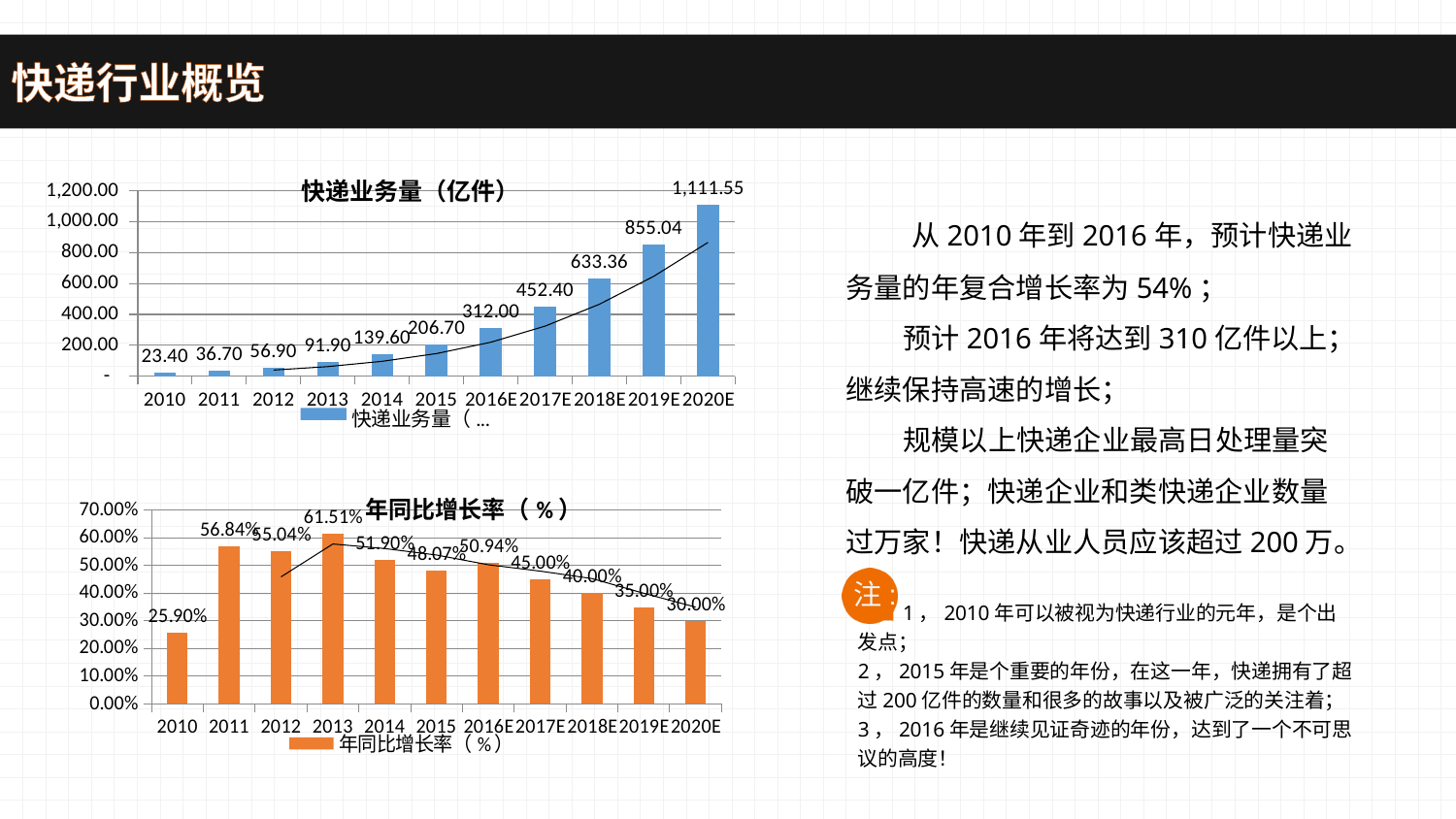
In the 快递业务量（亿件） chart, what is the value for 2015? 206.70 In the 年同比增长率（%） chart, what is the difference between the values for 2018E and 2019E? 5.00% In the 年同比增长率（%） chart, which year has the lowest value? 2010 In the 年同比增长率（%） chart, which is larger, the value for 2011 or the value for 2012? 2011 What kind of chart is the 年同比增长率（%） chart? bar chart In the 快递业务量（亿件） chart, do the values rise or fall from 2010 to 2020E? rise In the 快递业务量（亿件） chart, how many years are shown on the x axis? 11 In the 快递业务量（亿件） chart, what is the value for 2020E? 1,111.55 In the 快递业务量（亿件） chart, which year has the lowest value? 2010 In the 快递业务量（亿件） chart, what is the difference between the values for 2016E and 2015? 105.30 In the 年同比增长率（%） chart, which year has the highest value? 2013 In the 年同比增长率（%） chart, what is the value for 2013? 61.51%